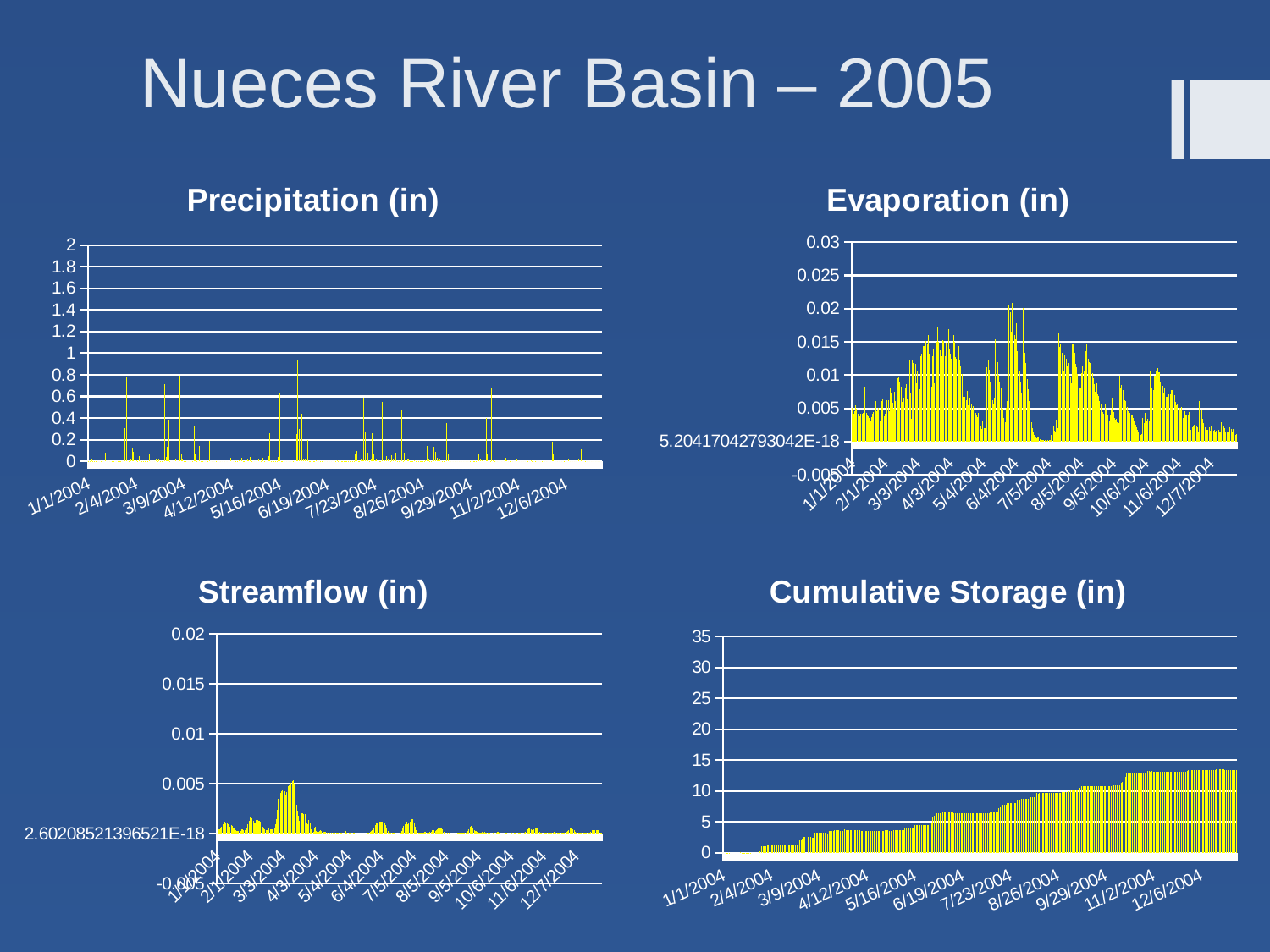
What kind of chart is the Cumulative Storage (in) chart? bar chart In the Cumulative Storage (in) chart, is the value at 12/6/2004 greater or less than 10? greater What is the title of the chart in the top-right of the slide? Evaporation (in) In the Cumulative Storage (in) chart, do the values rise or fall from 1/1/2004 to 12/6/2004? rise In the Precipitation (in) chart, is the highest bar greater or less than 1? less In the Evaporation (in) chart, is the highest value greater or less than 0.025? less What kind of chart is the Precipitation (in) chart? bar chart In the Cumulative Storage (in) chart, which is larger, the value at 9/29/2004 or the value at 4/12/2004? 9/29/2004 How many charts are shown on the slide? 4